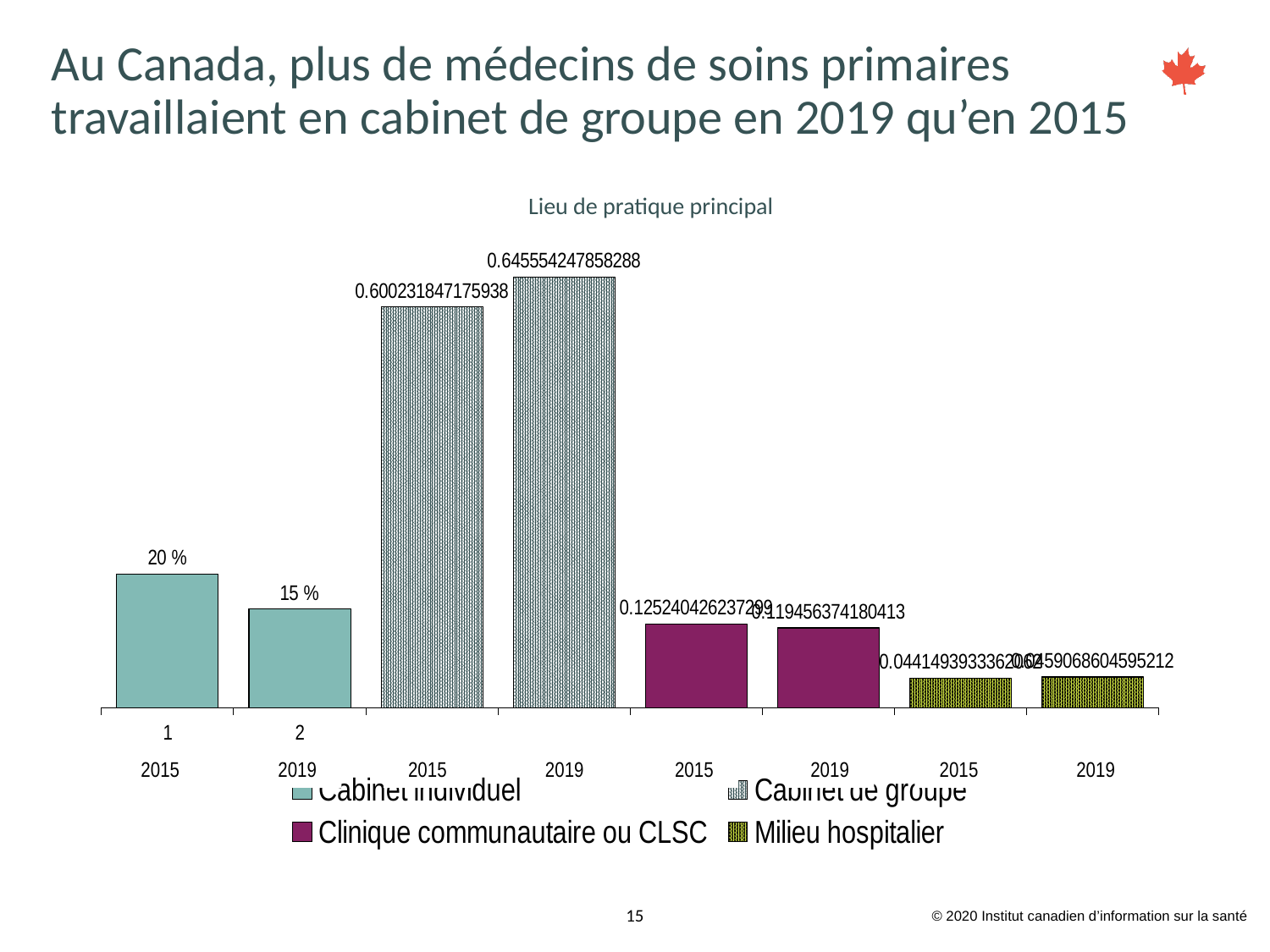
What is the value for Cabinet de groupe in 2015? 0.600231847175938 For Cabinet de groupe, which year has the larger value, 2015 or 2019? 2019 Which bar is the highest in the chart? Cabinet de groupe, 2019 What is the difference between the Cabinet individuel values for 2015 and 2019? 5 % What is the title of the chart? Lieu de pratique principal What is the value for Cabinet de groupe in 2019? 0.645554247858288 What is the value for Cabinet individuel in 2019? 15 % What kind of chart is shown on the slide? bar chart What is the value for Cabinet individuel in 2015? 20 % How many bars are plotted in the chart? 8 How many series does the legend list? 4 Which series has the lowest bars in the chart? Milieu hospitalier